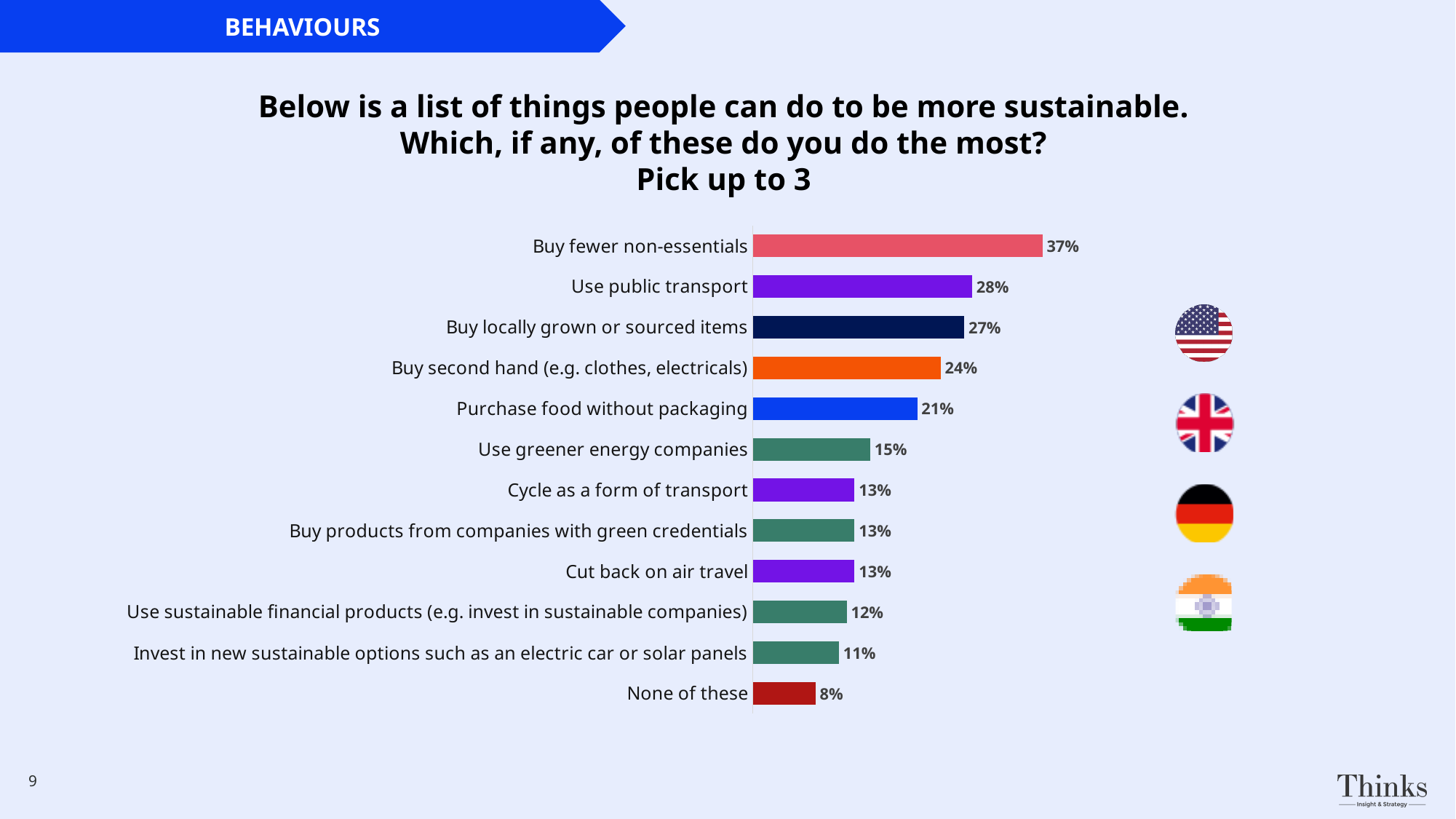
What is the difference between 'Buy fewer non-essentials' and 'Use public transport'? 9 percentage points Which behaviour has the highest percentage? Buy fewer non-essentials What is the value for 'None of these'? 8% What type of chart is shown on the slide? Bar chart What is the difference between 'Buy second hand (e.g. clothes, electricals)' and 'Use greener energy companies'? 9 percentage points What percentage of respondents said they buy fewer non-essentials? 37% How many categories are shown in the chart? 12 What percentage is shown for 'Purchase food without packaging'? 21% How many categories share the value 13%? 3 Which category has the lowest percentage? None of these Which is larger: 'Buy locally grown or sourced items' or 'Buy second hand (e.g. clothes, electricals)'? Buy locally grown or sourced items What is the value shown for 'Use public transport'? 28%